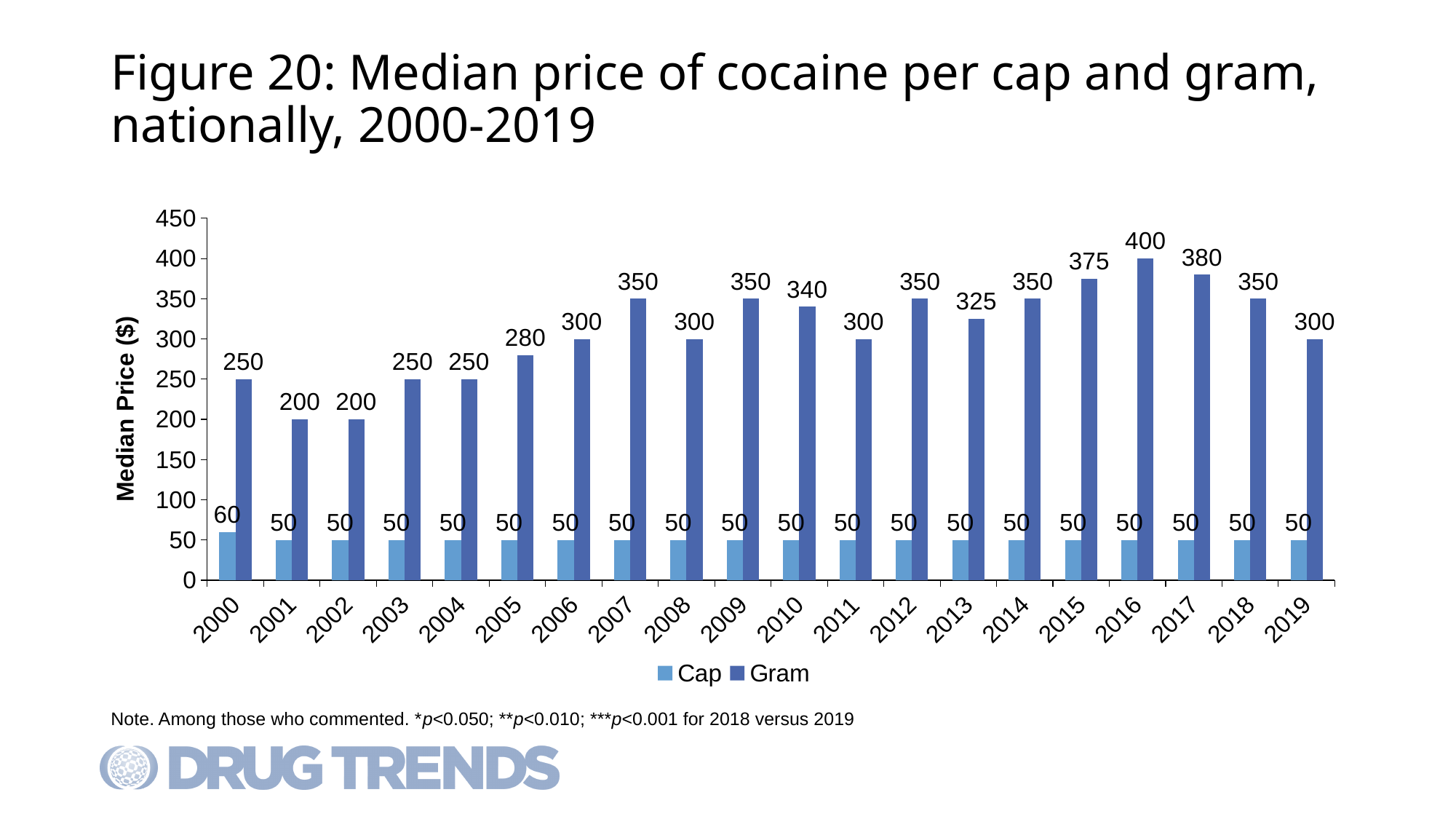
What is the median price per cap of cocaine in 2000? 60 In which year is the median price per cap highest? 2000 What is the difference between the median price per gram in 2016 and in 2019? 100 How many series does the legend list? 2 What is the median price per gram of cocaine in 2016? 400 What kind of chart is shown on the slide? Bar chart Does the median price per gram rise or fall from 2016 to 2019? Fall How many years are shown on the x axis? 20 What is the median price per gram of cocaine in 2005? 280 What is the label of the y axis? Median Price ($) In which year is the median price per gram highest? 2016 Which is larger, the median price per gram in 2017 or in 2018? 2017